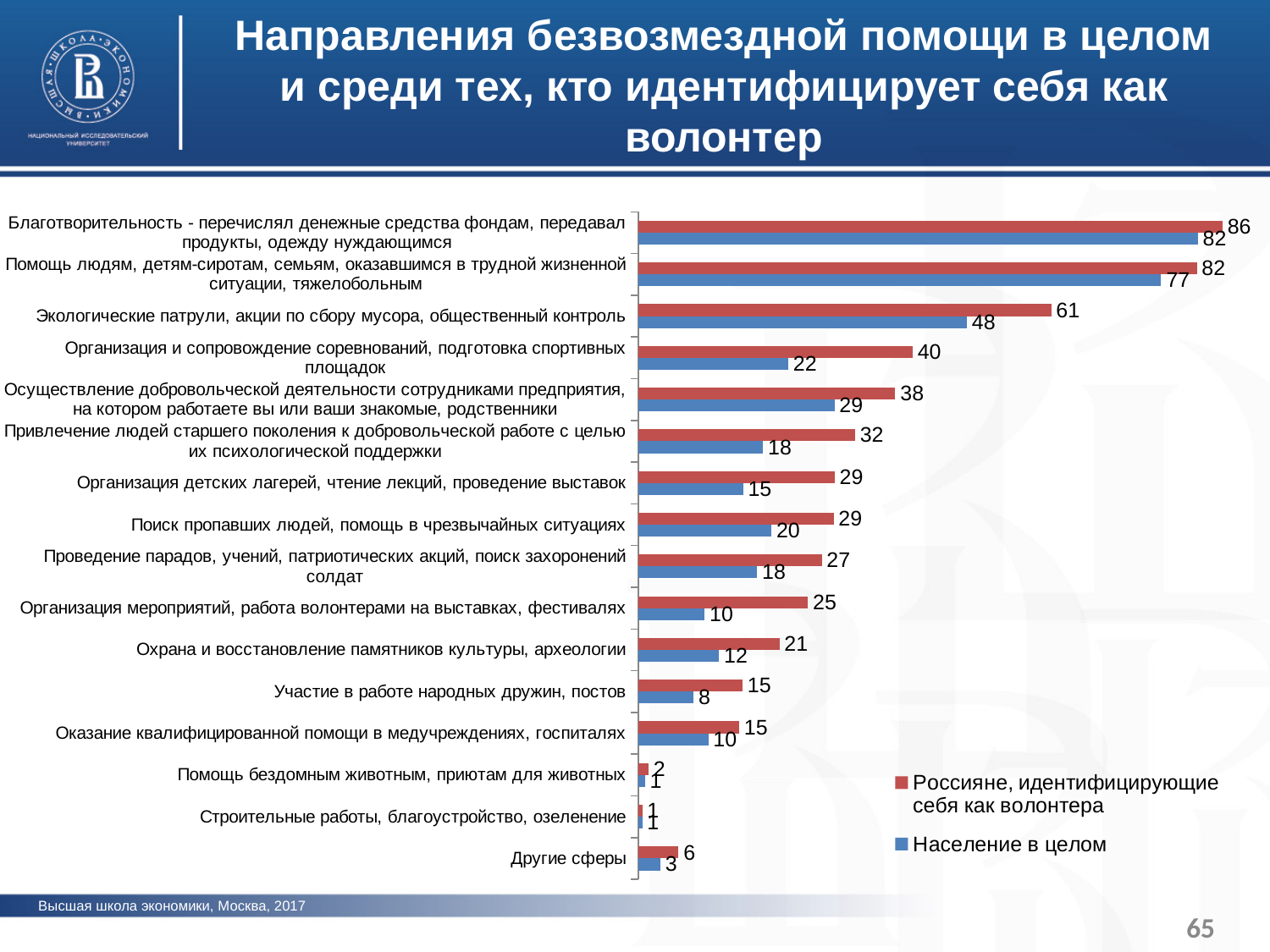
For "Организация мероприятий, работа волонтерами на выставках, фестивалях", which series has the larger value? Россияне, идентифицирующие себя как волонтера What type of chart is shown on the slide? bar chart How many series does the legend list? 2 What is the difference between the two series for "Организация и сопровождение соревнований, подготовка спортивных площадок"? 18 Which category has the highest value in the series "Население в целом"? Благотворительность - перечислял денежные средства фондам, передавал продукты, одежду нуждающимся Which colour represents the series "Население в целом"? blue What is the value for "Охрана и восстановление памятников культуры, археологии" in the series "Россияне, идентифицирующие себя как волонтера"? 21 What is the difference between "Экологические патрули, акции по сбору мусора, общественный контроль" and "Помощь людям, детям-сиротам, семьям, оказавшимся в трудной жизненной ситуации, тяжелобольным" in the series "Население в целом"? 29 How many categories are plotted on the chart? 16 What is the value for "Экологические патрули, акции по сбору мусора, общественный контроль" in the series "Россияне, идентифицирующие себя как волонтера"? 61 What is the value for "Поиск пропавших людей, помощь в чрезвычайных ситуациях" in the series "Население в целом"? 20 Which category has the lowest value in the series "Россияне, идентифицирующие себя как волонтера"? Строительные работы, благоустройство, озеленение